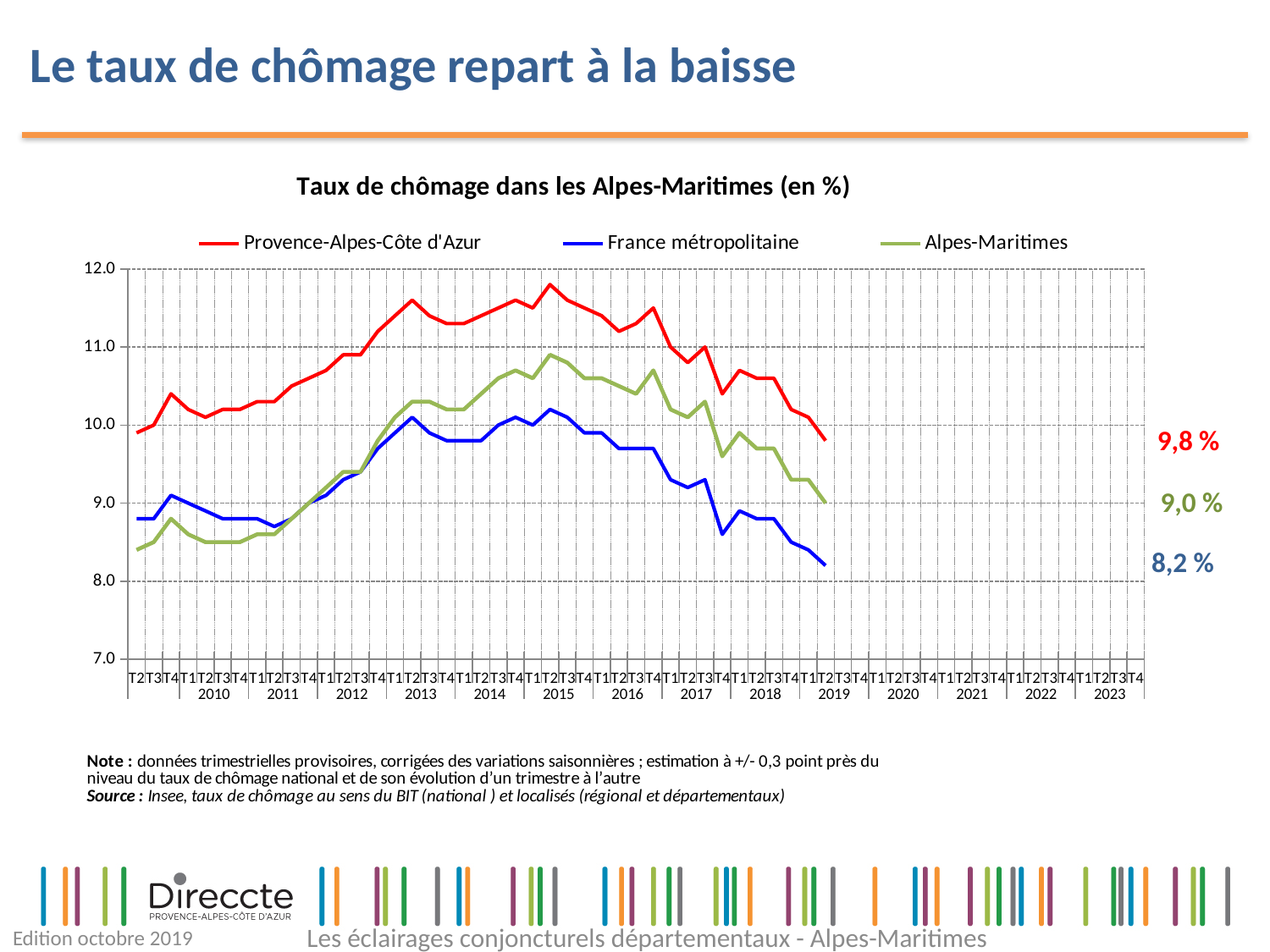
Which series has the highest value at the end of the plotted period? Provence-Alpes-Côte d'Azur What kind of chart is shown on the slide? line chart Which series has the lowest value at the end of the plotted period? France métropolitaine How many series does the legend list? 3 Is the value for Alpes-Maritimes in 2010 greater or less than 9.0? less What is the latest value shown for Alpes-Maritimes? 9,0 % What is the latest value shown for Provence-Alpes-Côte d'Azur? 9,8 % Does the Provence-Alpes-Côte d'Azur line rise or fall between 2017 and 2019? fall What is the difference between the latest values for Provence-Alpes-Côte d'Azur and France métropolitaine? 1,6 points What is the latest value shown for France métropolitaine? 8,2 % What is the title of the chart? Taux de chômage dans les Alpes-Maritimes (en %) Is the peak value for Provence-Alpes-Côte d'Azur in 2015 greater or less than 11.0? greater